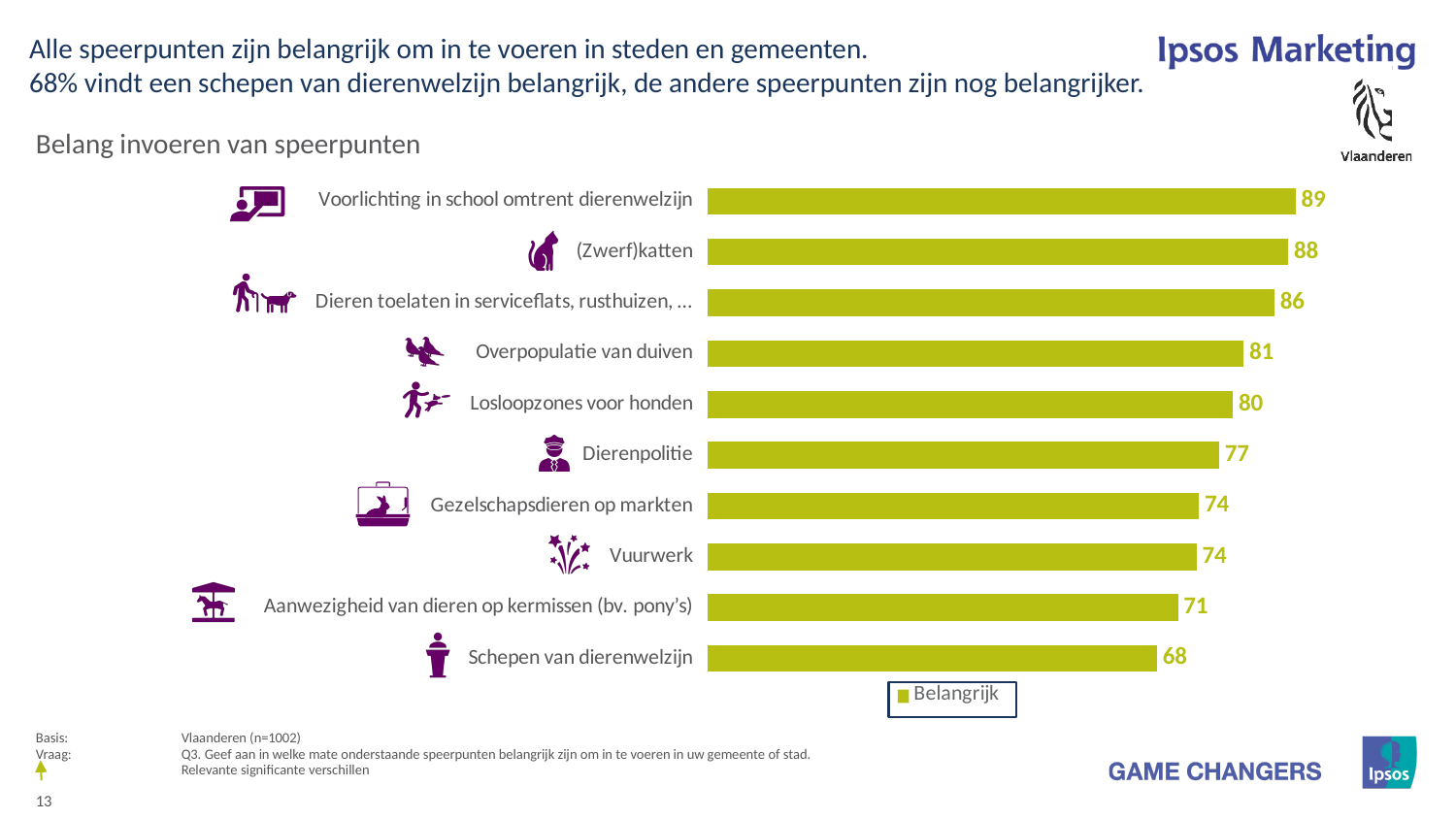
What is the value for "Schepen van dierenwelzijn"? 68 What is the value for "Voorlichting in school omtrent dierenwelzijn"? 89 Which has a larger value, "Overpopulatie van duiven" or "Vuurwerk"? Overpopulatie van duiven How many series does the legend list? 1 What is the value for "Losloopzones voor honden"? 80 What kind of chart is shown on the slide? Bar chart Which category has the lowest value? Schepen van dierenwelzijn How many categories are shown in the chart? 10 What is the title of the chart? Belang invoeren van speerpunten What is the name of the series shown in the legend? Belangrijk What is the difference between the values for "(Zwerf)katten" and "Dierenpolitie"? 11 Which category has the highest value? Voorlichting in school omtrent dierenwelzijn